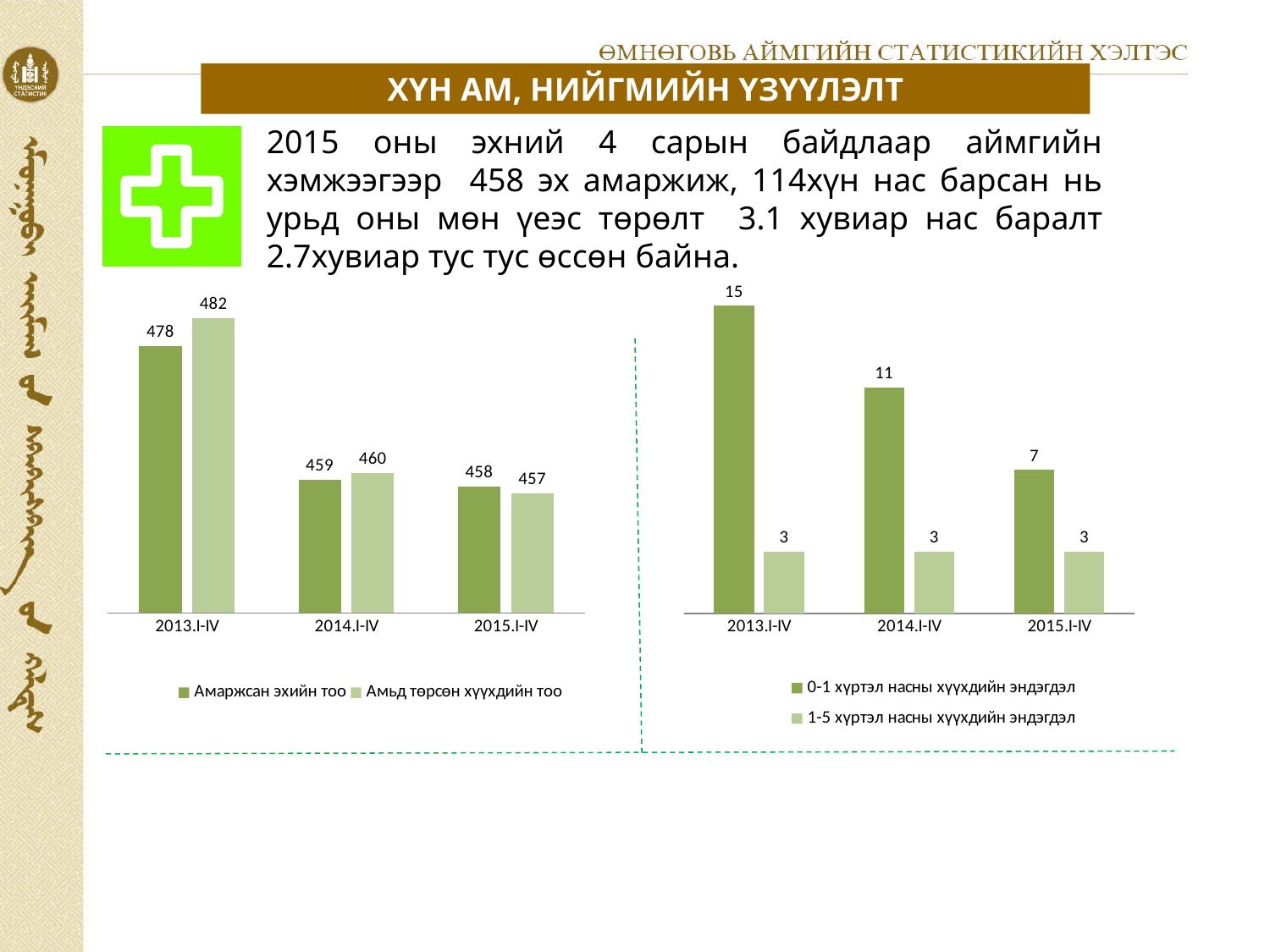
In the left chart, what is the value of Амьд төрсөн хүүхдийн тоо for 2015.I-IV? 457 In the right chart, what is the value of 0-1 хүртэл насны хүүхдийн эндэгдэл for 2014.I-IV? 11 In the left chart, which period has the highest value for Амьд төрсөн хүүхдийн тоо? 2013.I-IV In the left chart, what is the difference between Амьд төрсөн хүүхдийн тоо and Амаржсан эхийн тоо in 2013.I-IV? 4 In the right chart, how many periods are shown on the x axis? 3 In the right chart, which period has the lowest value for 0-1 хүртэл насны хүүхдийн эндэгдэл? 2015.I-IV In the right chart, what is the value of 1-5 хүртэл насны хүүхдийн эндэгдэл for 2015.I-IV? 3 In the left chart, how many series does the legend list? 2 In the left chart, what is the value of Амаржсан эхийн тоо for 2013.I-IV? 478 In the right chart, what is the difference between 0-1 хүртэл насны хүүхдийн эндэгдэл in 2013.I-IV and 2015.I-IV? 8 What type of chart is the right chart? bar chart In the left chart, does Амаржсан эхийн тоо rise or fall from 2013.I-IV to 2015.I-IV? fall